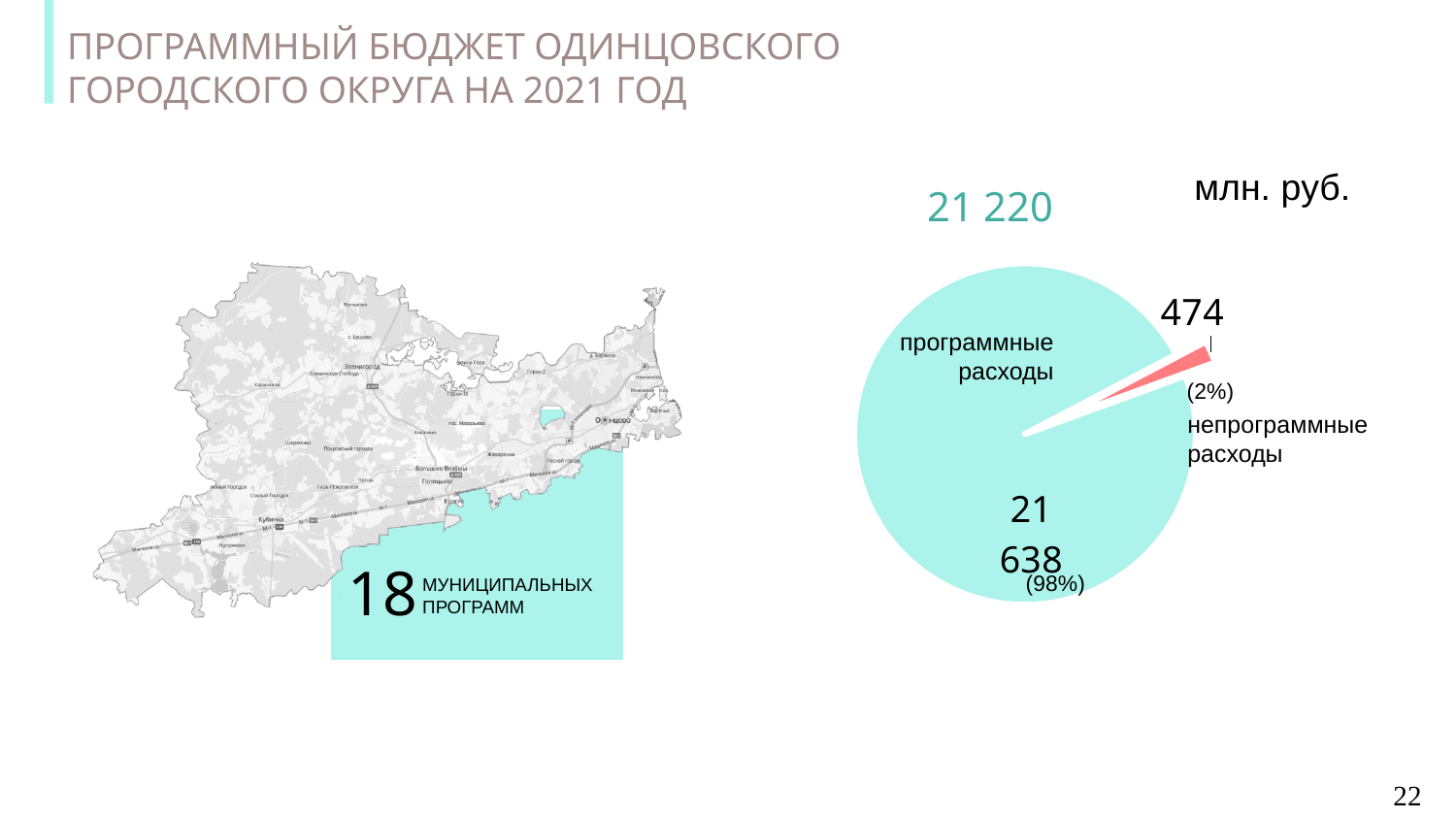
What share of the pie does непрограммные расходы represent? 2% Which is larger in the pie chart, программные расходы or непрограммные расходы? программные расходы What kind of chart is shown on the slide? pie chart What value is shown for программные расходы in the pie chart? 21 638 Which slice of the pie chart is the largest? программные расходы What colour is the непрограммные расходы slice in the pie chart? red (pink) What value is shown for непрограммные расходы in the pie chart? 474 How many slices does the pie chart have? 2 Which slice of the pie chart is the smallest? непрограммные расходы What unit is indicated for the values in the pie chart? млн. руб. What share of the pie does программные расходы represent? 98%